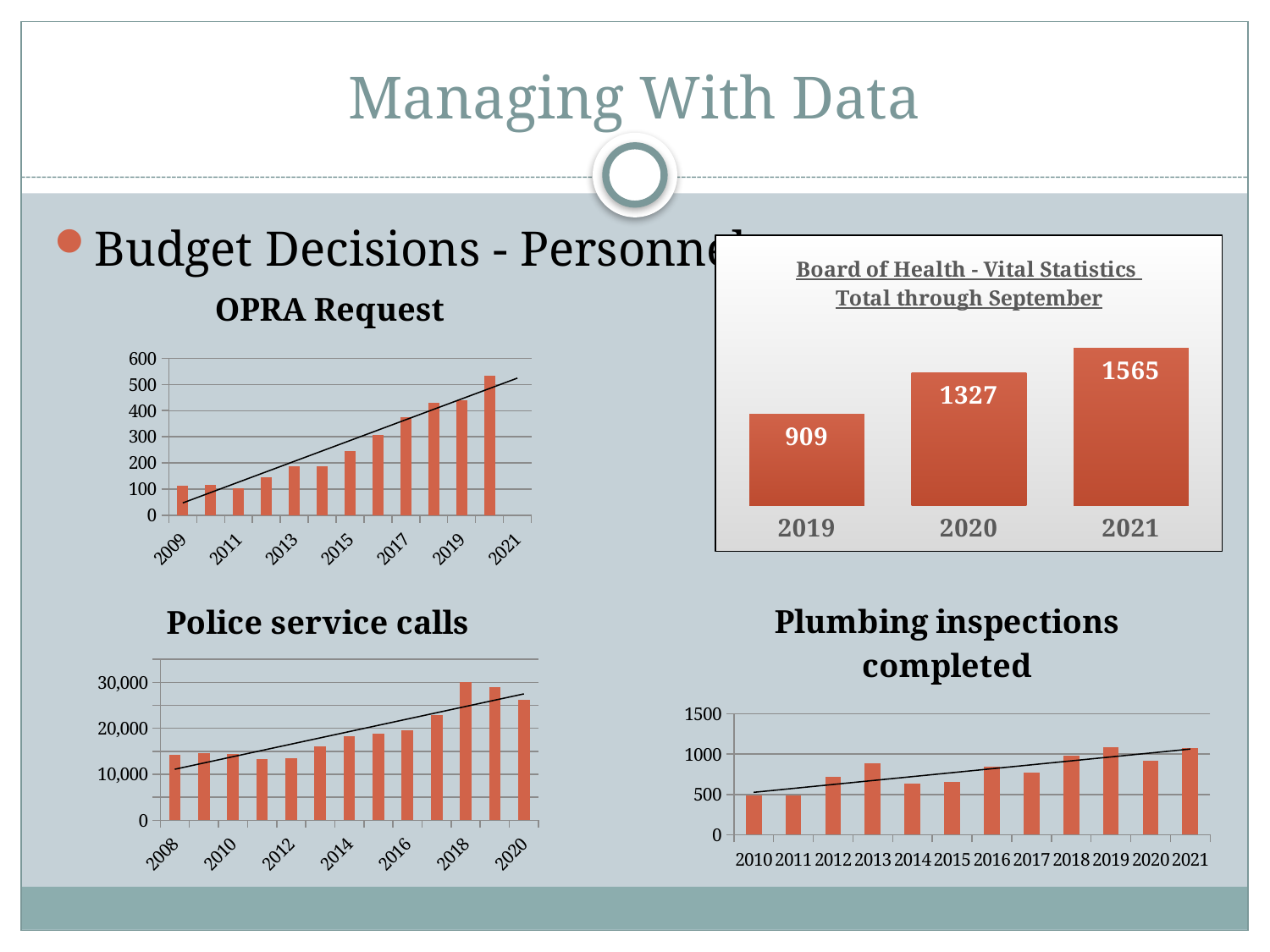
In the Plumbing inspections completed chart, is the value for 2019 greater or less than 1000? greater In the Plumbing inspections completed chart, how many years are shown on the x axis? 12 In the Police service calls chart, is the value for 2008 greater or less than 10,000? greater What kind of chart is the Plumbing inspections completed chart? bar chart In the OPRA Request chart, do the values generally rise or fall from 2009 to 2021? rise In the Board of Health - Vital Statistics chart, what is the value for 2020? 1327 In the Board of Health - Vital Statistics chart, how many years are shown? 3 In the OPRA Request chart, which year has the highest value? 2020 In the Board of Health - Vital Statistics chart, what is the difference between the 2021 and 2019 values? 656 In the Board of Health - Vital Statistics chart, which year has the highest value? 2021 In the Police service calls chart, is the value for 2020 greater or less than 30,000? less